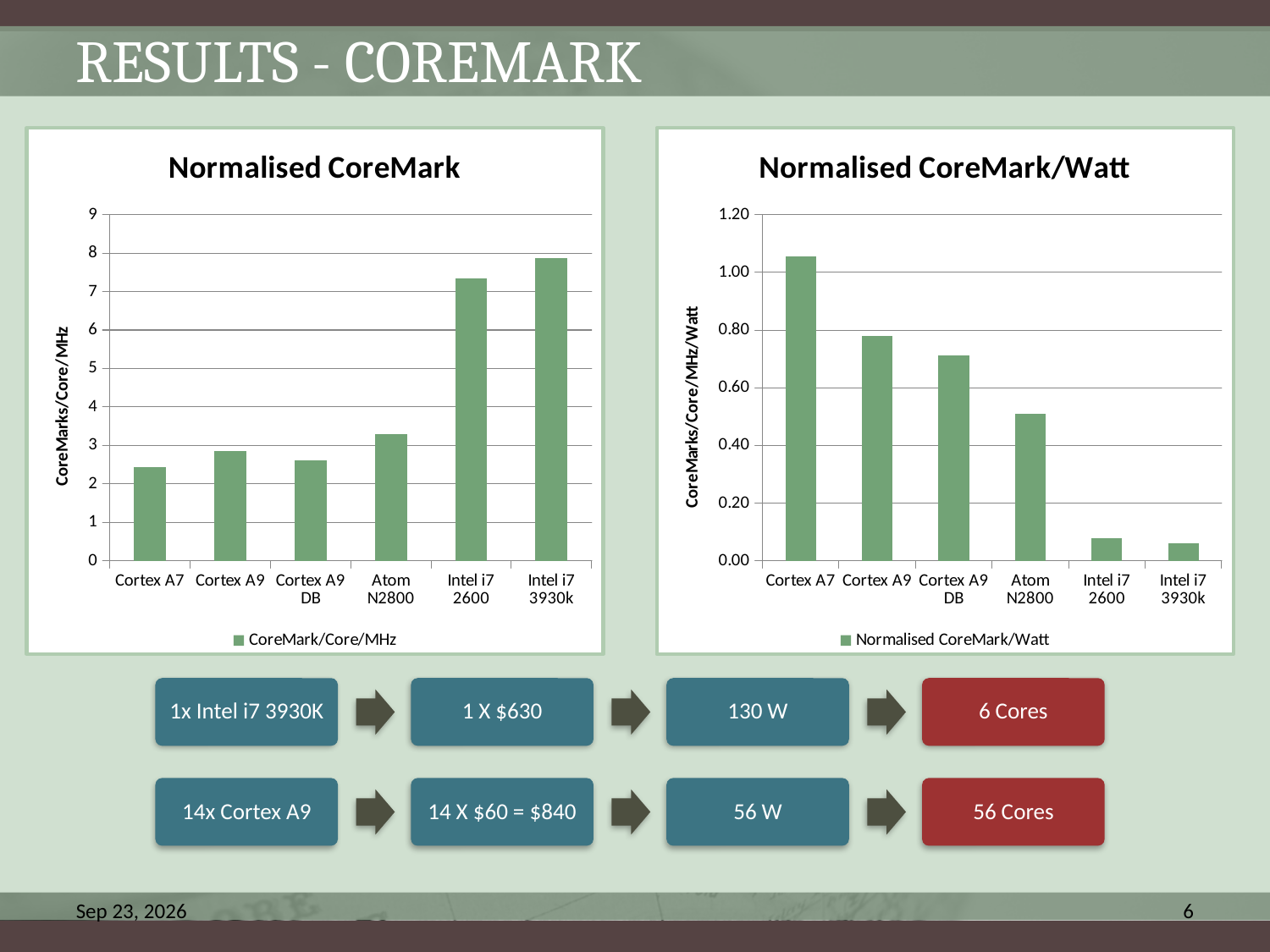
In the Normalised CoreMark chart, is the value for Cortex A7 greater or less than 3? less What kind of chart is the Normalised CoreMark chart? bar chart In the Normalised CoreMark/Watt chart, is the value for Intel i7 2600 greater or less than 0.20? less In the Normalised CoreMark/Watt chart, do the values rise or fall from left to right along the x axis? fall In the Normalised CoreMark/Watt chart, which category has the highest value? Cortex A7 In the Normalised CoreMark chart, is the value for Intel i7 2600 greater or less than 7? greater How many series does the legend of the Normalised CoreMark/Watt chart list? 1 How many categories are shown in the Normalised CoreMark chart? 6 In the Normalised CoreMark chart, which is larger, the value for Atom N2800 or the value for Cortex A9? Atom N2800 What is the y-axis label of the Normalised CoreMark chart? CoreMarks/Core/MHz In the Normalised CoreMark chart, which category has the highest value? Intel i7 3930k